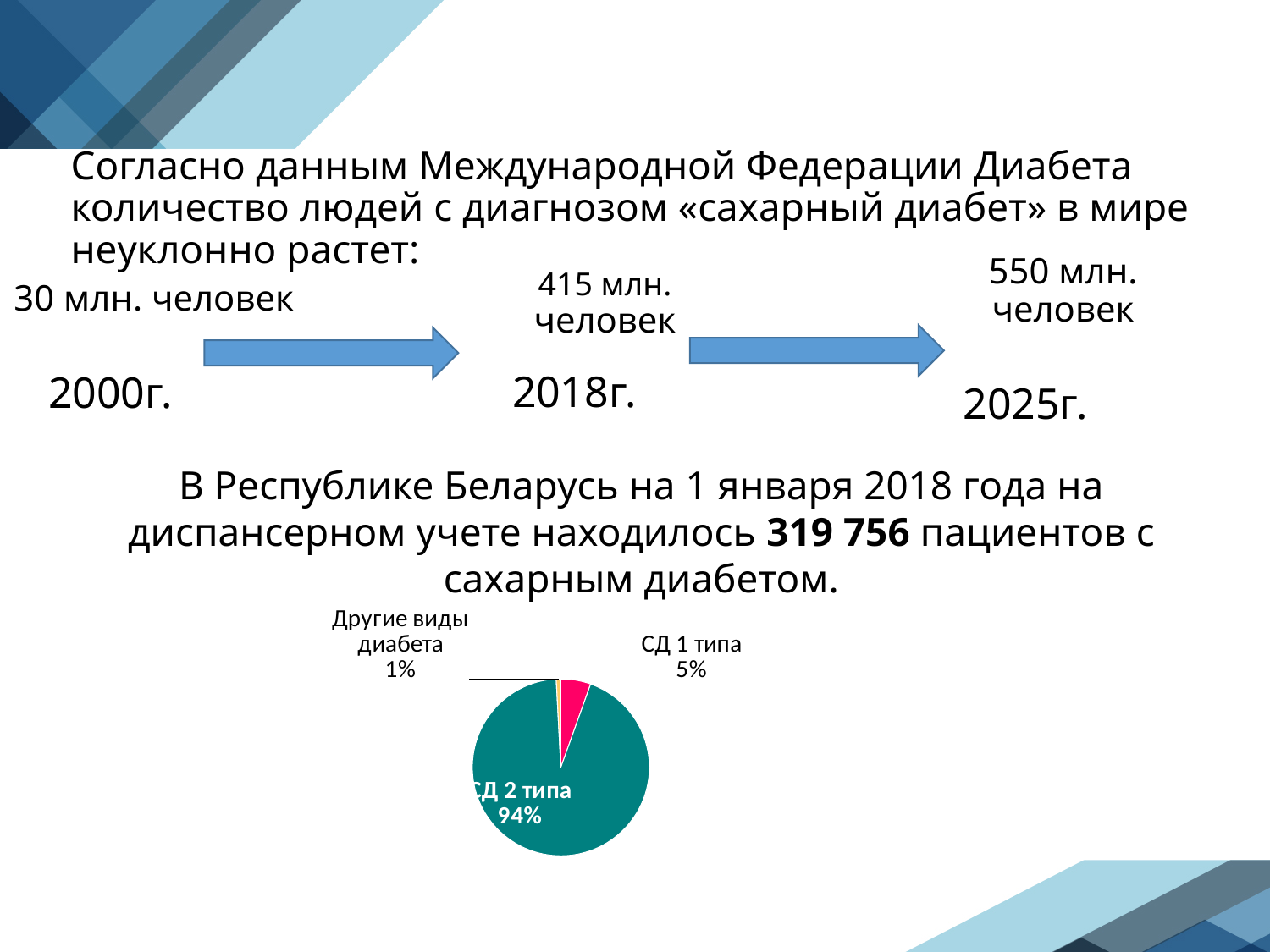
What colour is the СД 1 типа slice in the pie chart? Pink What is the difference in percentage points between СД 1 типа and Другие виды диабета? 4 What colour is the СД 2 типа slice in the pie chart? Teal Which is larger in the pie chart, СД 1 типа or Другие виды диабета? СД 1 типа What share of the pie does Другие виды диабета have? 1% What share of the pie does СД 2 типа have? 94% What kind of chart is shown at the bottom of the slide? Pie chart What is the difference in percentage points between СД 2 типа and СД 1 типа? 89 Which slice of the pie chart is the smallest? Другие виды диабета What share of the pie does СД 1 типа have? 5% Which slice of the pie chart is the largest? СД 2 типа How many slices does the pie chart have? 3